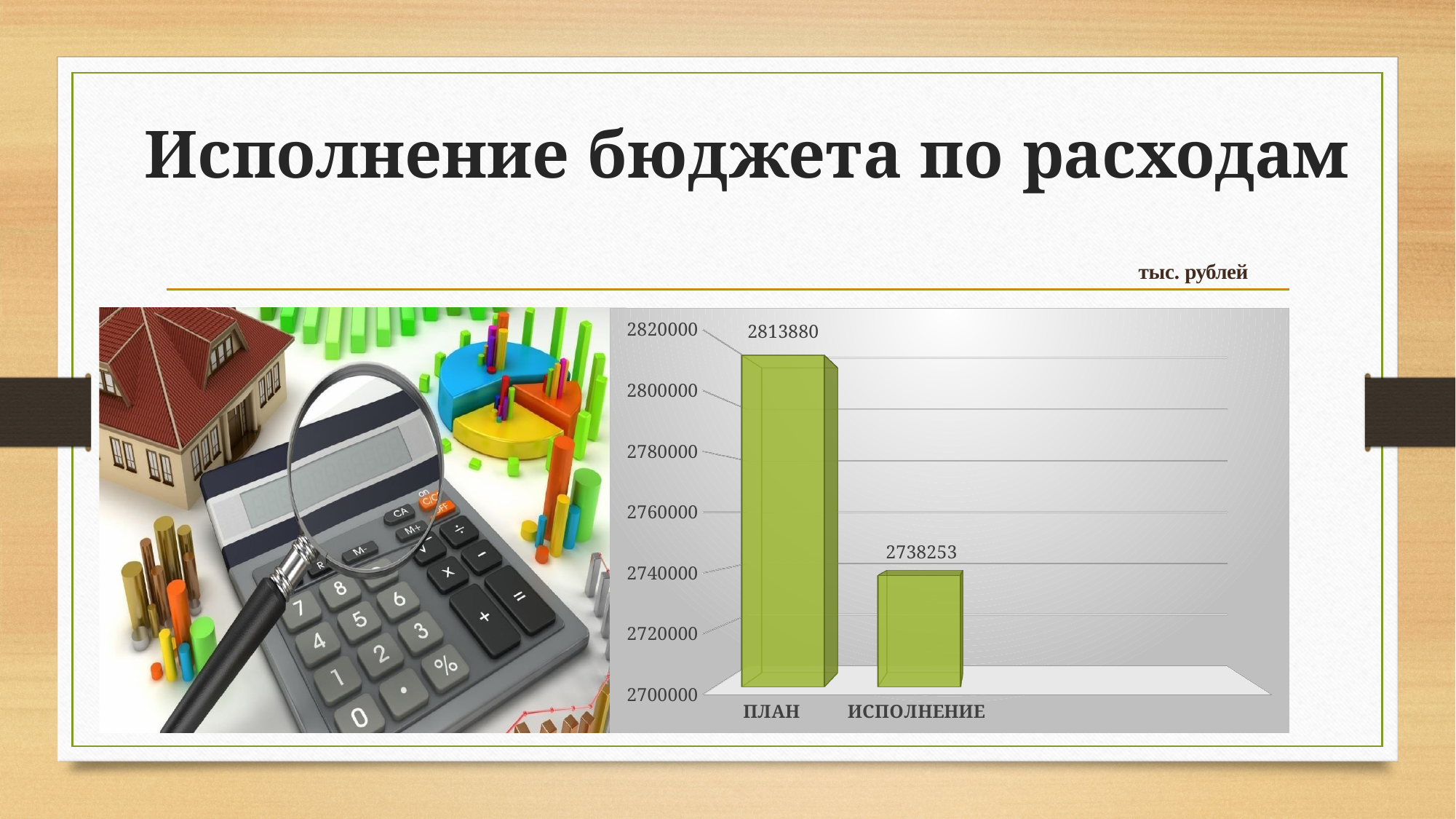
What unit is indicated above the chart? тыс. рублей Which category has the lowest value? ИСПОЛНЕНИЕ Which is larger, the value for ПЛАН or the value for ИСПОЛНЕНИЕ? ПЛАН What is the value for ПЛАН? 2813880 Do the values rise or fall from ПЛАН to ИСПОЛНЕНИЕ? fall What kind of chart is shown on the slide? bar chart What is the difference between the values for ПЛАН and ИСПОЛНЕНИЕ? 75627 Is the value for ПЛАН greater or less than 2800000? greater What is the value for ИСПОЛНЕНИЕ? 2738253 Is the value for ИСПОЛНЕНИЕ greater or less than 2740000? less How many categories are shown on the chart? 2 Which category has the highest value? ПЛАН